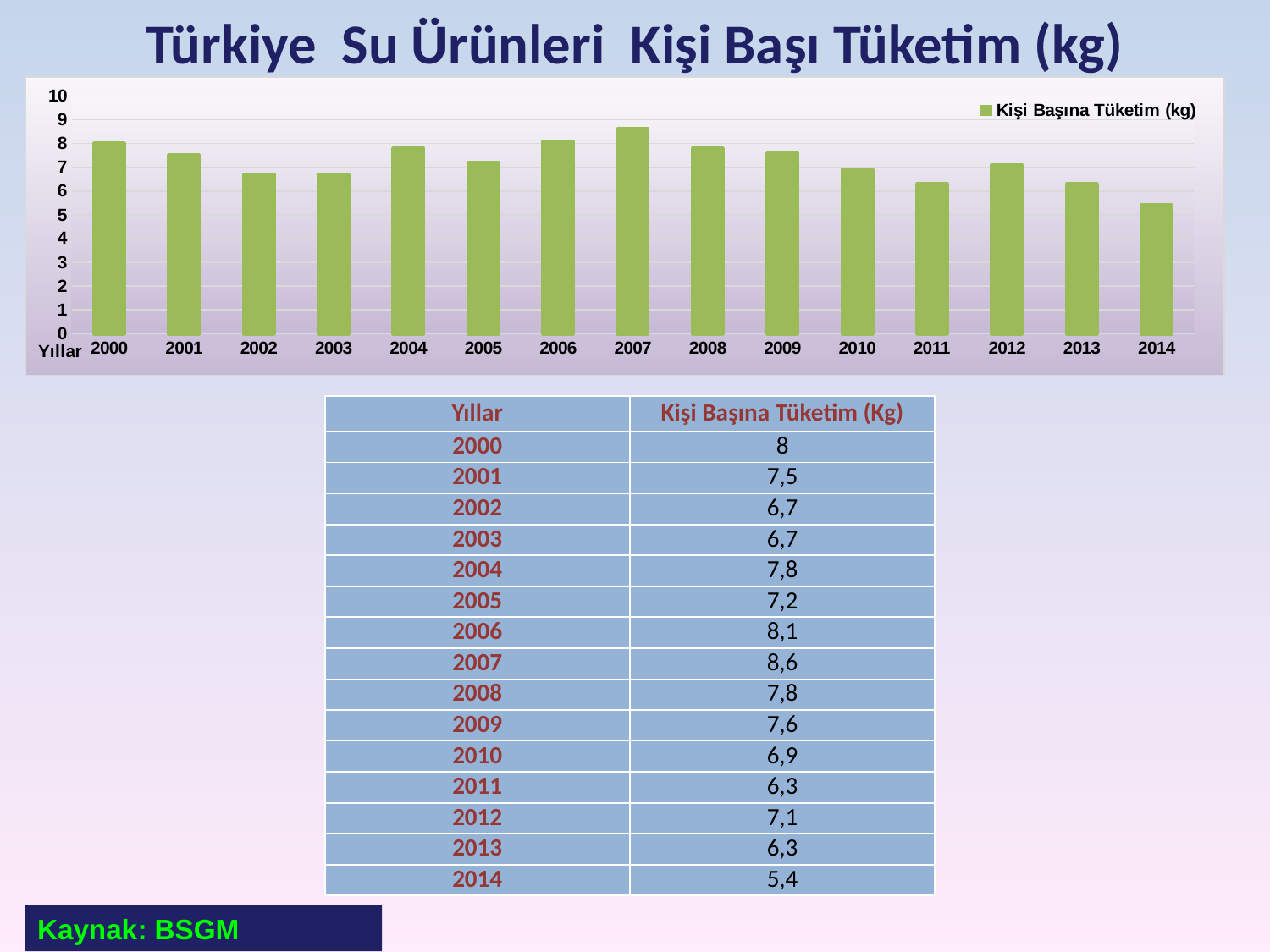
What is the per-capita consumption value for 2014? 5,4 How many years are shown on the x axis of the chart? 15 Which year has the lowest per-capita consumption? 2014 What is the title of the chart? Türkiye Su Ürünleri Kişi Başı Tüketim (kg) What is the difference between the per-capita consumption in 2007 and in 2014? 3,2 What is the per-capita consumption value for 2007? 8,6 What kind of chart is shown on the slide? bar chart Which year has the larger per-capita consumption, 2006 or 2009? 2006 Is the value for 2014 greater or less than 6? less Which year has the highest per-capita consumption? 2007 What is the per-capita consumption value for 2000? 8 How many series does the chart legend list? 1